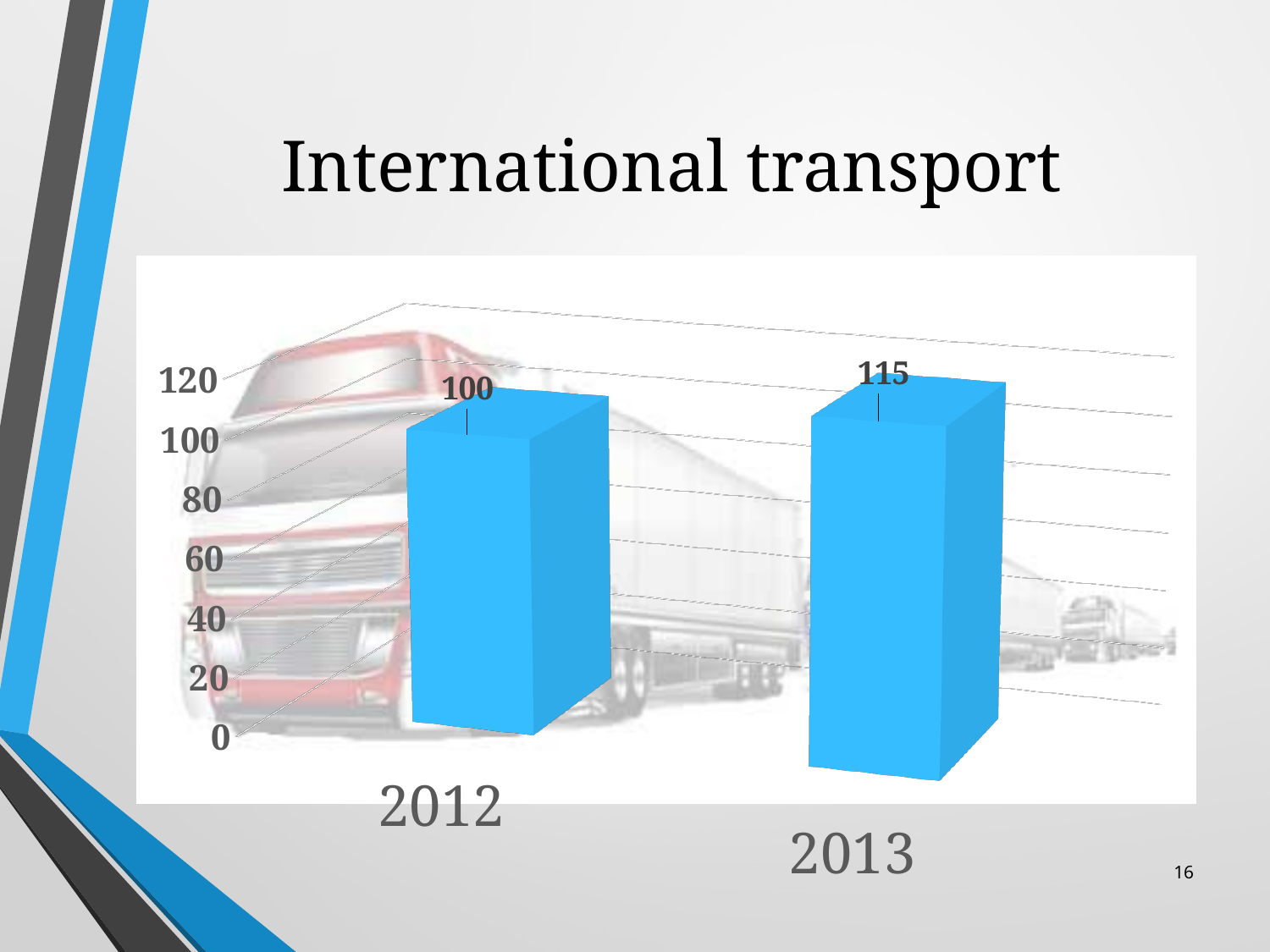
How many categories are shown in the chart? 2 Which is larger, the value for 2012 or the value for 2013? 2013 Which year has the lowest value? 2012 What is the value for 2013? 115 What is the difference between the values for 2013 and 2012? 15 What kind of chart is shown on the slide? bar chart Is the value for 2013 greater or less than 120? less What is the title of the slide containing the chart? International transport Which year has the highest value? 2013 Do the values rise or fall from 2012 to 2013? rise Is the value for 2012 greater or less than 80? greater What is the value for 2012? 100